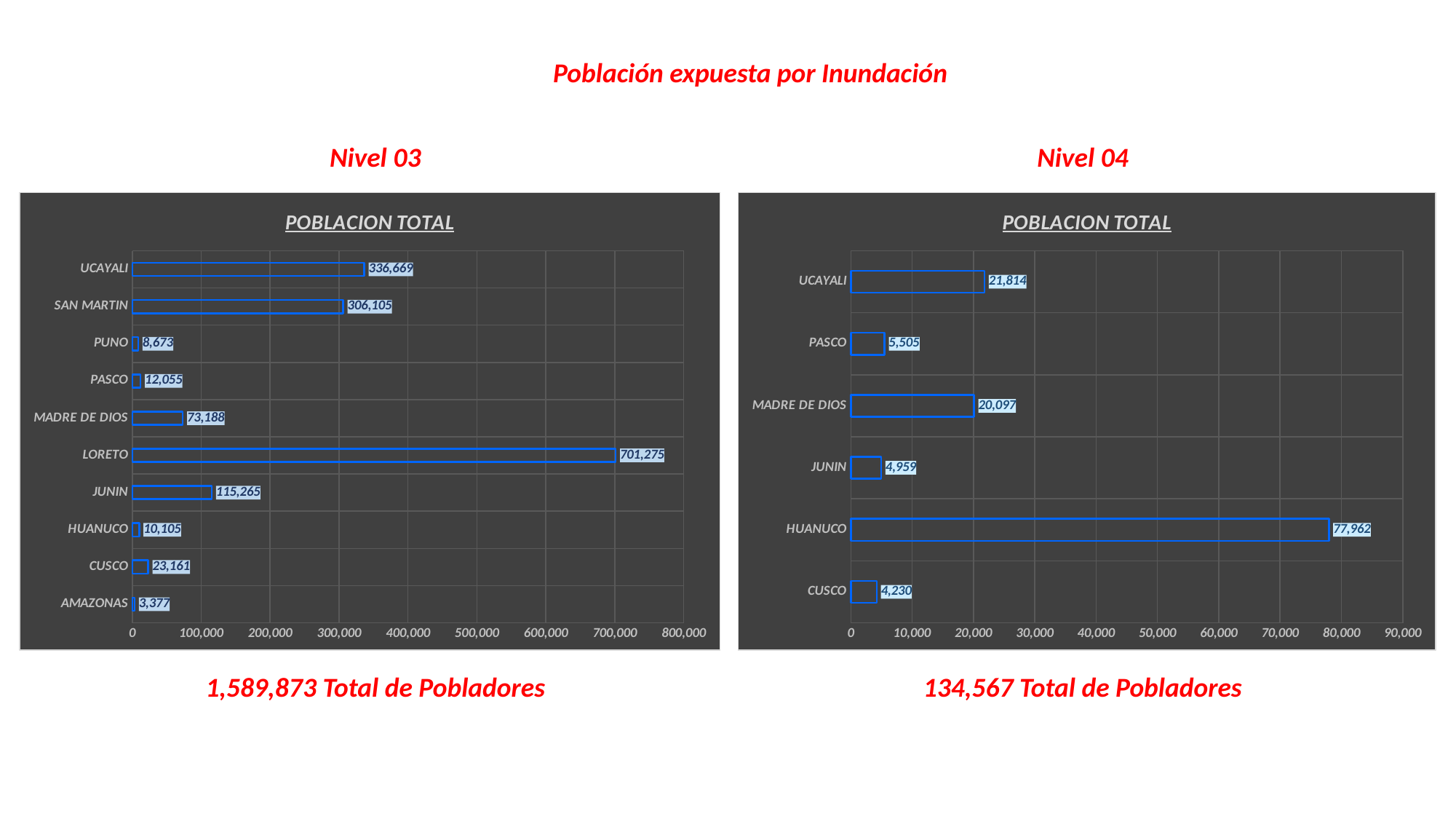
How many categories are shown in the Nivel 04 chart? 6 In the Nivel 03 chart, which category has the lowest value? AMAZONAS In the Nivel 04 chart, which category has the lowest value? CUSCO In the Nivel 04 chart, what is the value for MADRE DE DIOS? 20,097 In the Nivel 03 chart, what is the value for LORETO? 701,275 In the Nivel 03 chart, what is the difference between the values for UCAYALI and SAN MARTIN? 30,564 In the Nivel 03 chart, what is the value for SAN MARTIN? 306,105 How many categories are shown in the Nivel 03 chart? 10 What kind of chart is the Nivel 04 chart? Bar chart In the Nivel 04 chart, which category has the highest value? HUANUCO In the Nivel 04 chart, what is the difference between the values for UCAYALI and PASCO? 16,309 In the Nivel 03 chart, which is larger, the value for JUNIN or the value for MADRE DE DIOS? JUNIN